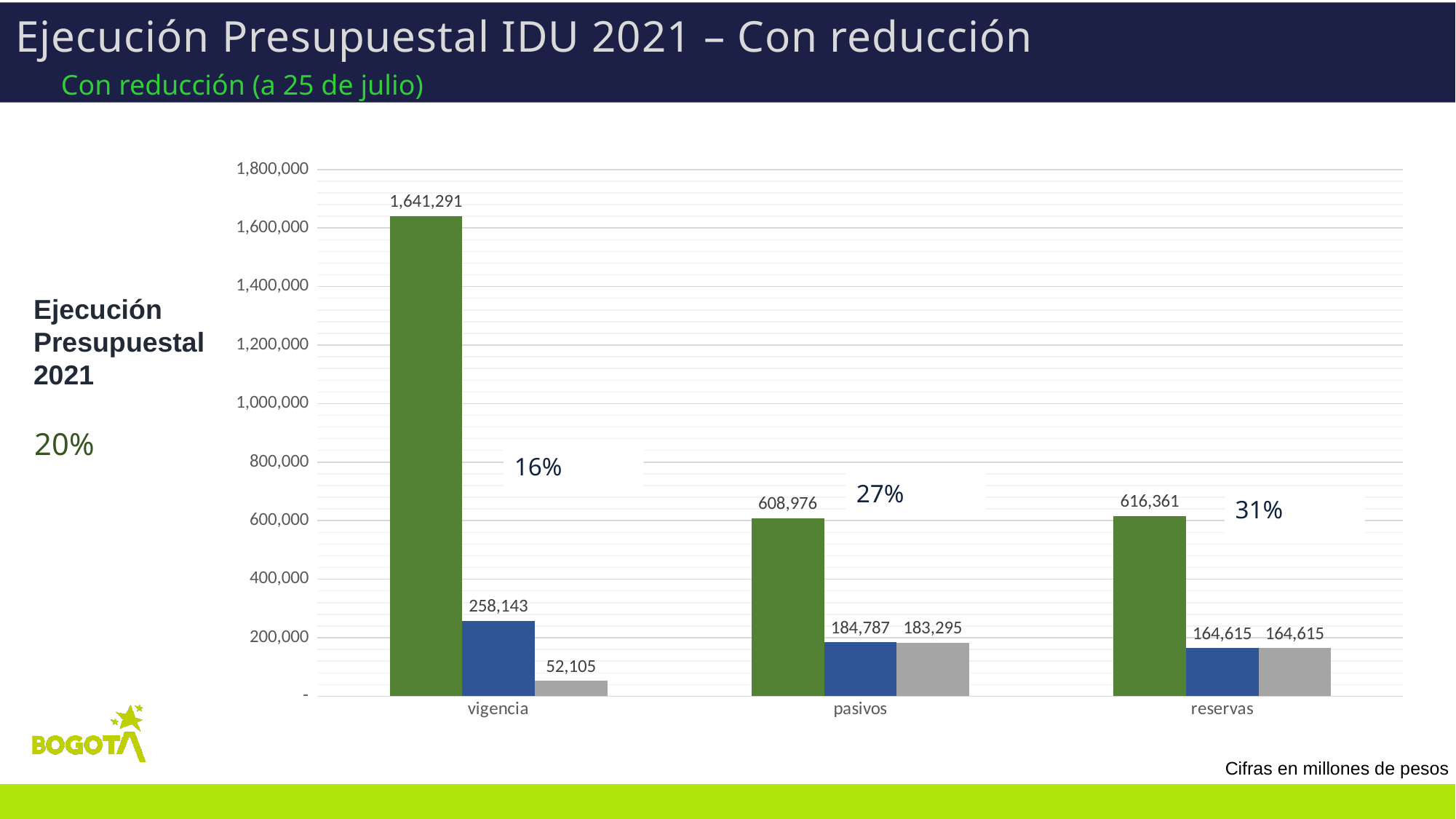
What is the value of the green bar for reservas? 616,361 Which category has the highest green bar? vigencia How many categories are shown on the x axis? 3 What percentage label is shown next to the reservas group? 31% What is the value of the green bar for vigencia? 1,641,291 Is the green bar for pasivos greater or less than 800,000? less What is the value of the blue bar for pasivos? 184,787 Which category has the lowest gray bar? vigencia What kind of chart is shown on the slide? bar chart What is the difference between the green bar for vigencia and the green bar for pasivos? 1,032,315 What is the value of the gray bar for vigencia? 52,105 Which is larger, the blue bar for vigencia or the blue bar for reservas? the blue bar for vigencia